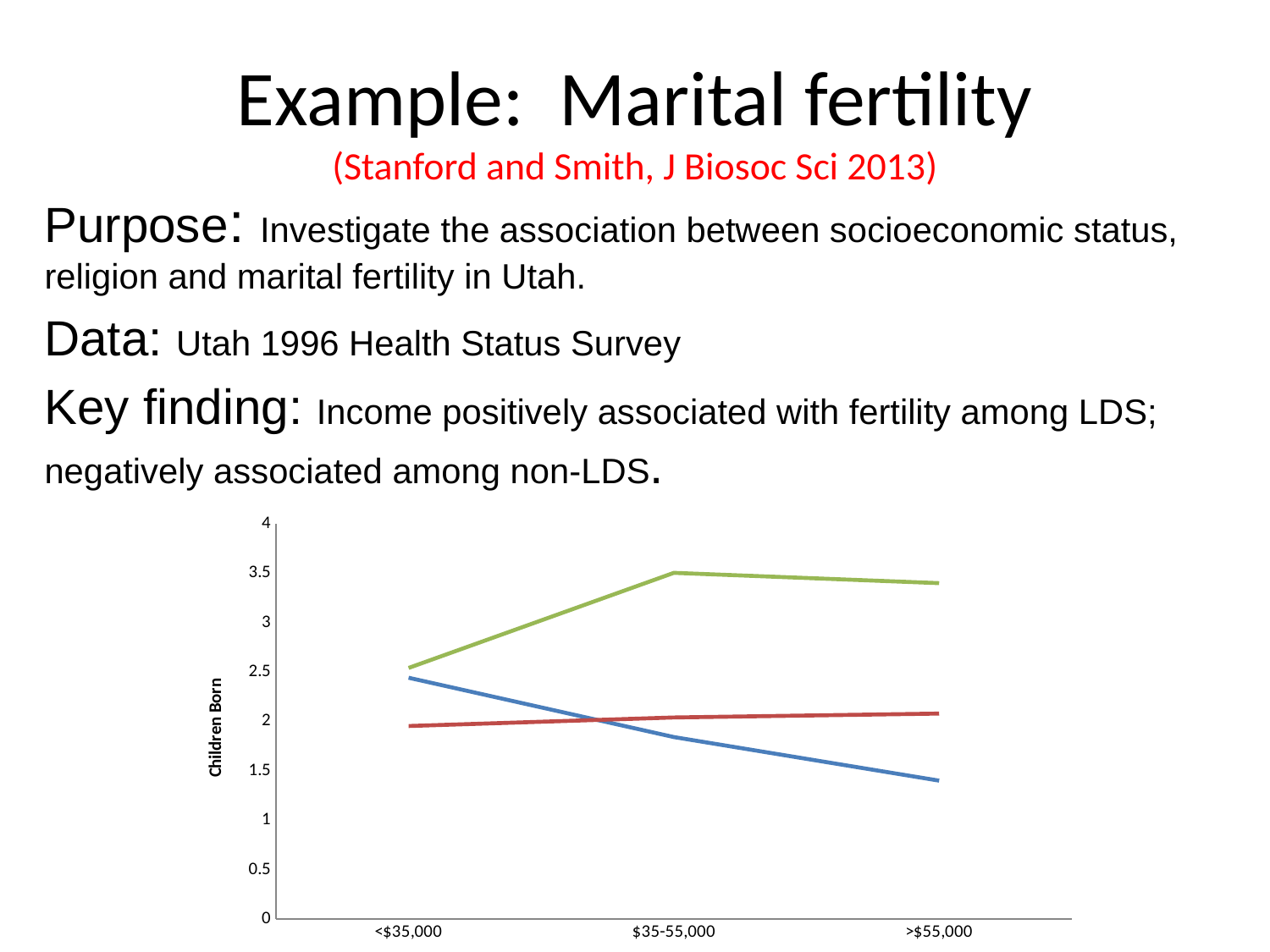
How many income categories are shown on the x axis? 3 Is the value of the blue line at $35-55,000 greater or less than 2? less Does the blue line rise or fall as income increases from <$35,000 to >$55,000? fall How many lines are plotted on the chart? 3 At >$55,000, which line has the higher value, the green line or the blue line? green line What is the title of the vertical axis? Children Born At <$35,000, which line has the higher value, the blue line or the red line? blue line At which income category does the blue line reach its lowest value? >$55,000 What kind of chart is shown on the slide? line chart Is the value of the green line at >$55,000 greater or less than 3? greater Is the value of the blue line at <$35,000 greater or less than 2? greater